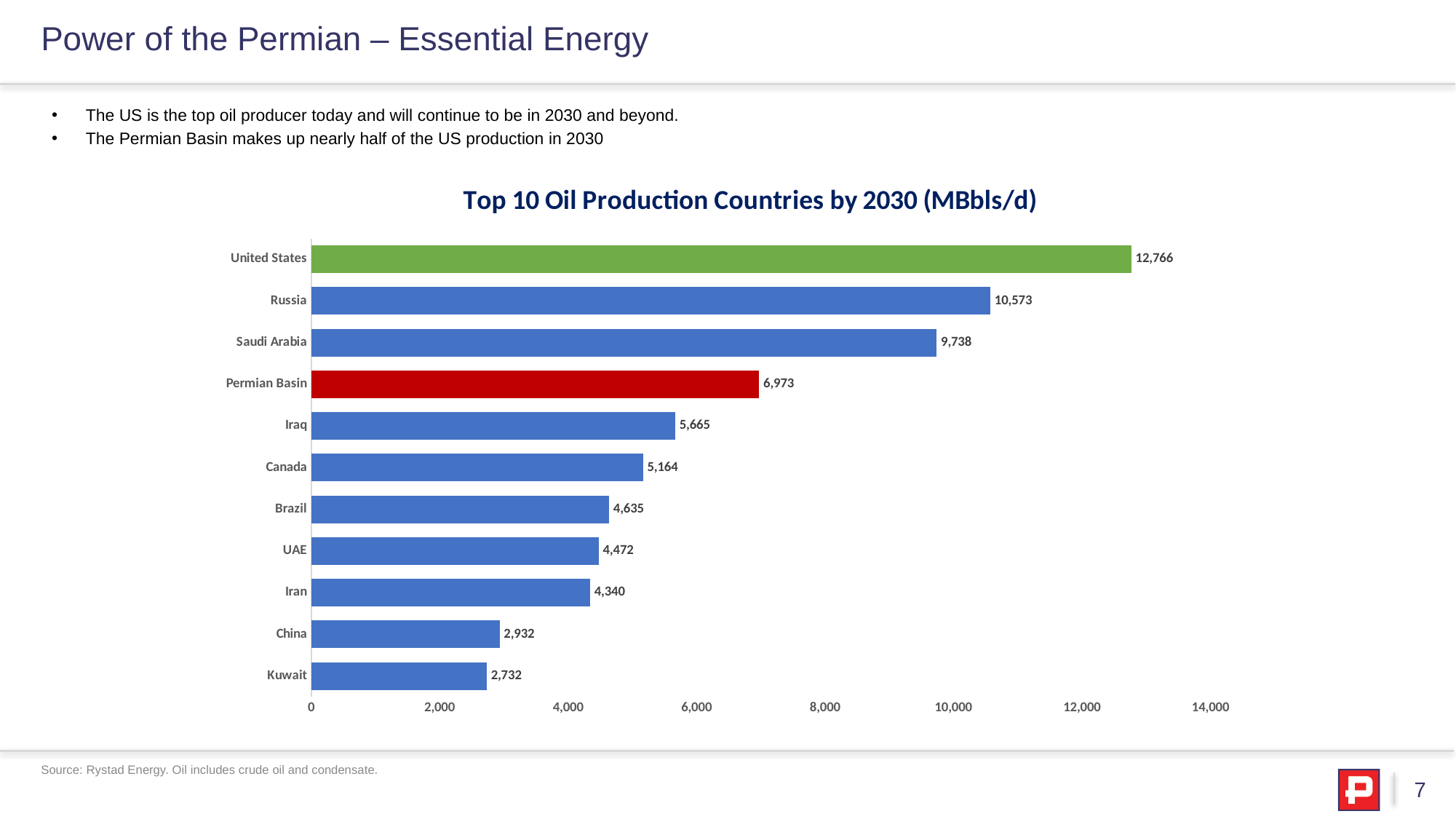
What is the difference between the values for Russia and Saudi Arabia? 835 Which category has the lowest value? Kuwait Which is larger, the value for Iraq or the value for Canada? Iraq What is the value for Kuwait? 2,732 What kind of chart is shown on the slide? bar chart Which category has the highest value? United States How many bars are shown in the chart? 11 Which bar is coloured red? Permian Basin What is the value for the United States? 12,766 Is the value for Brazil greater or less than 4,000? greater What is the title of the chart? Top 10 Oil Production Countries by 2030 (MBbls/d) What is the value for the Permian Basin? 6,973